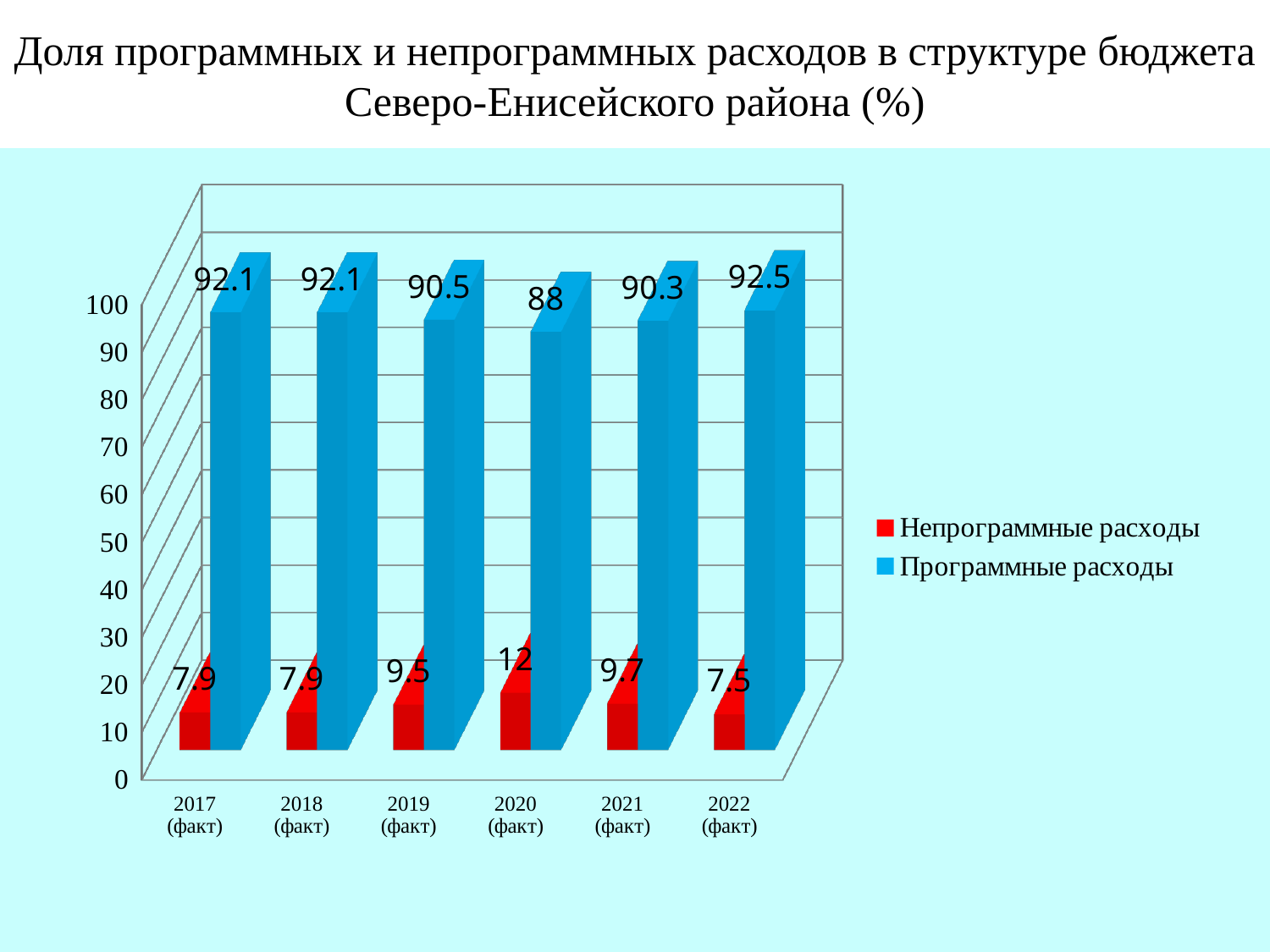
В каком году доля программных расходов наибольшая? 2022 (факт) В каком году доля непрограммных расходов наибольшая? 2020 (факт) Какое значение имеют непрограммные расходы в 2019 (факт)? 9.5 В каком году доля программных расходов наименьшая? 2020 (факт) Какого типа эта диаграмма? Столбчатая (bar chart) Что больше: доля программных расходов в 2019 (факт) или в 2021 (факт)? 2019 (факт) Сколько рядов данных указано в легенде? 2 На сколько доля непрограммных расходов в 2020 (факт) больше, чем в 2022 (факт)? 4.5 Какое значение имеют программные расходы в 2020 (факт)? 88 Каким цветом обозначены непрограммные расходы в легенде? Красным Какое значение имеют программные расходы в 2022 (факт)? 92.5 Сколько категорий (лет) показано на оси x? 6